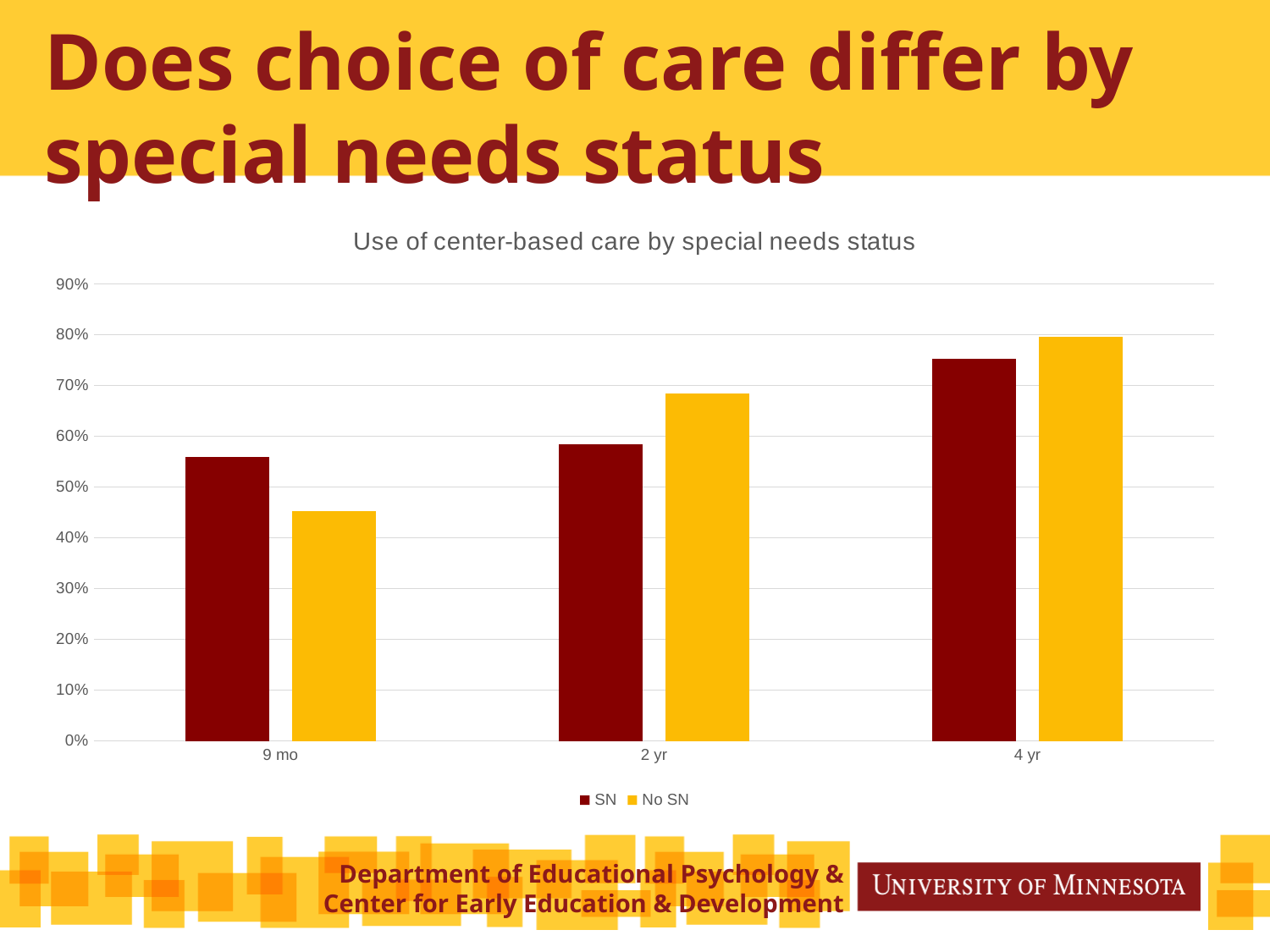
Which age category has the highest value for No SN? 4 yr Is the value for No SN at 9 mo greater or less than 50%? less Do the No SN values rise or fall from 9 mo to 4 yr? rise At 2 yr, which is larger, SN or No SN? No SN Is the value for No SN at 2 yr greater or less than 60%? greater How many age categories are shown on the x axis? 3 Is the value for SN at 4 yr greater or less than 70%? greater What type of chart is shown on the slide? bar chart What is the title of the chart? Use of center-based care by special needs status How many series does the legend list? 2 Which series is shown in dark red? SN At 9 mo, which is larger, SN or No SN? SN